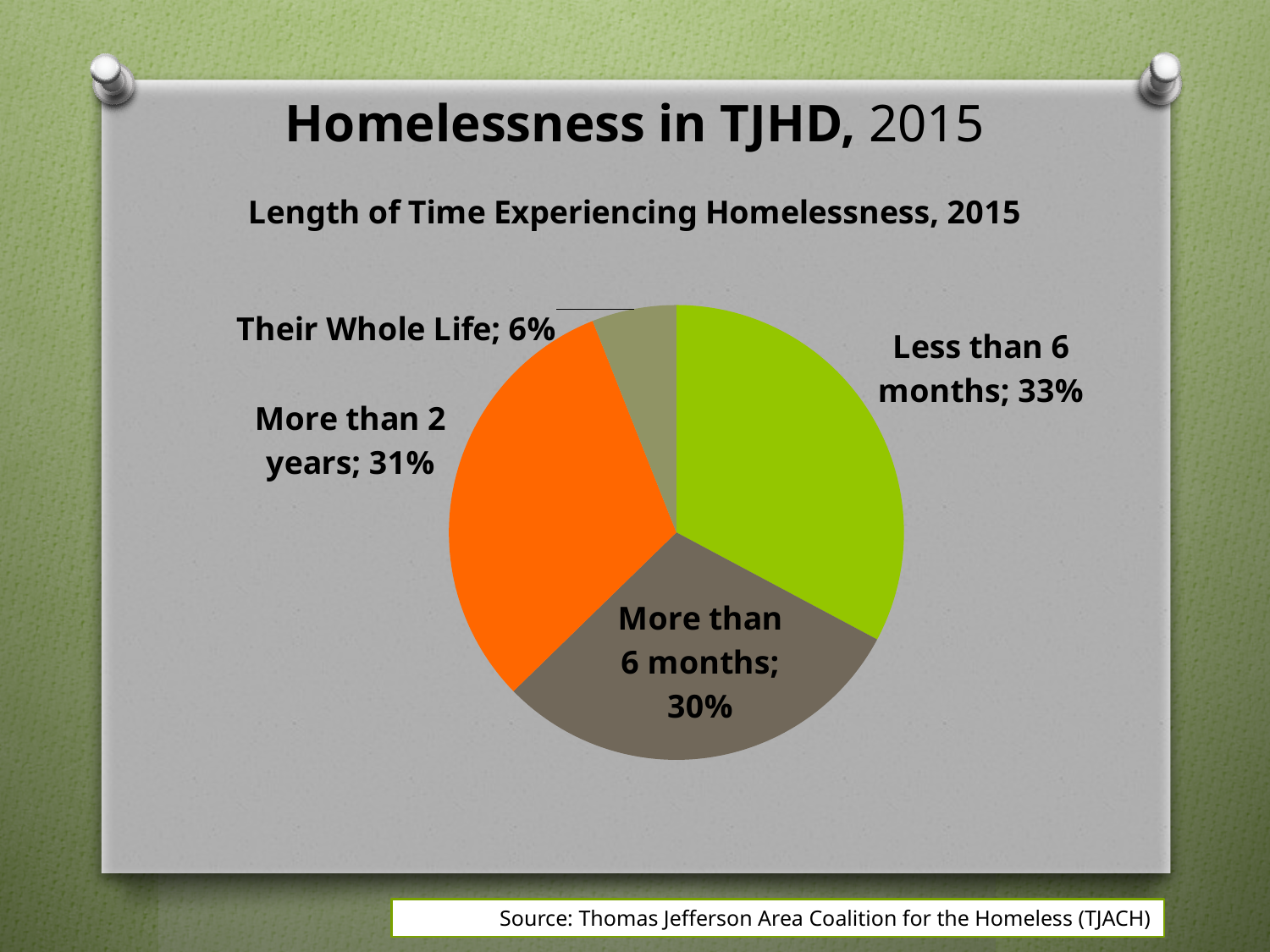
What share of the pie is labelled 'More than 6 months'? 30% What kind of chart is shown on the slide? Pie chart What is the title of the chart? Length of Time Experiencing Homelessness, 2015 What share of the pie is labelled 'More than 2 years'? 31% What share of the pie is labelled 'Their Whole Life'? 6% What colour is the 'More than 2 years' slice? Orange Which category has the smallest share of the pie? Their Whole Life Which category has the largest share of the pie? Less than 6 months What is the difference in percentage points between 'Less than 6 months' and 'Their Whole Life'? 27 What share of the pie is labelled 'Less than 6 months'? 33% How many slices does the pie chart have? 4 What is the difference in percentage points between 'More than 2 years' and 'More than 6 months'? 1